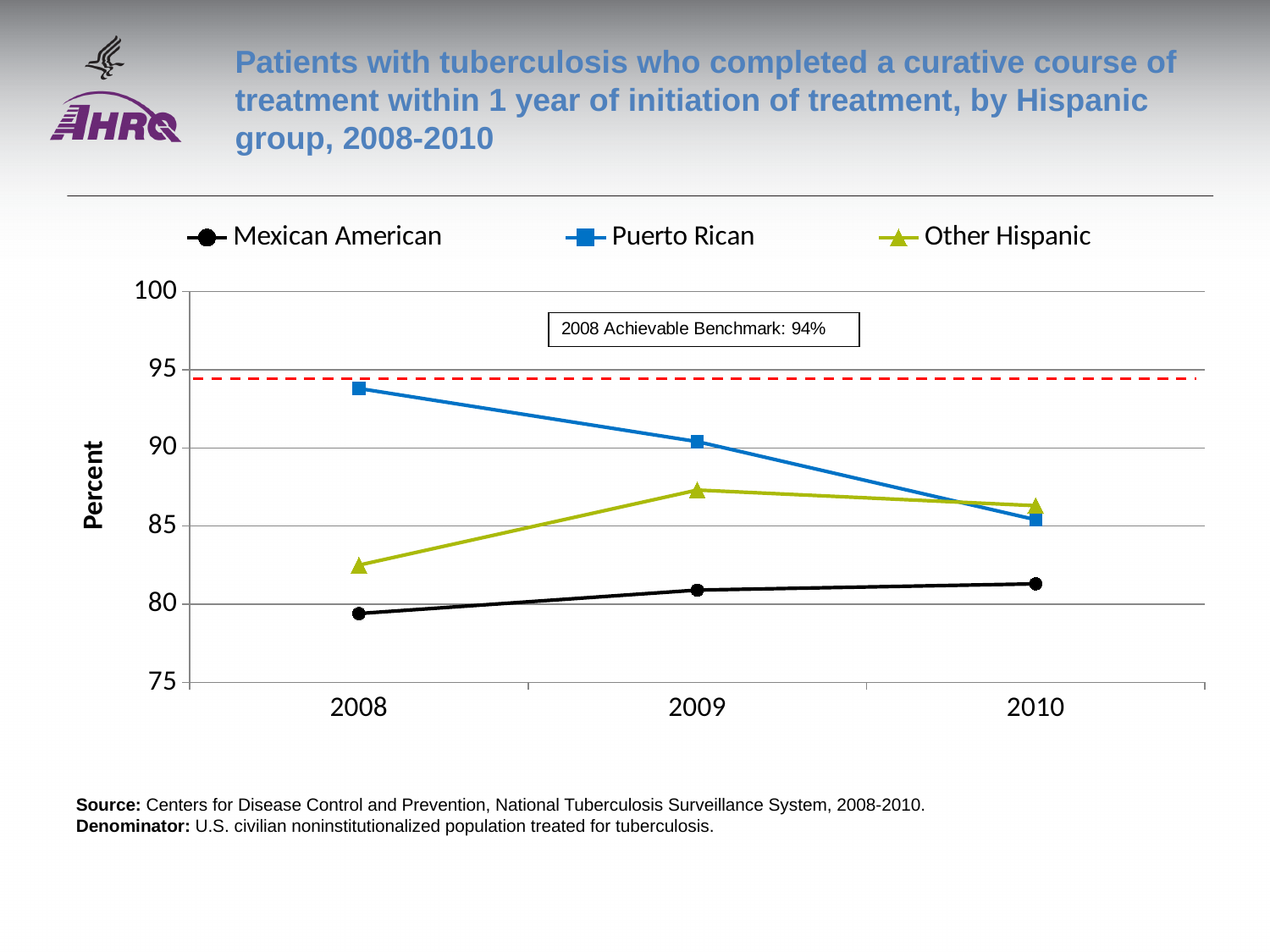
Is the value for Mexican American in 2008 greater or less than 80? less What kind of chart is shown on the slide? line chart Which group had the highest value in 2008? Puerto Rican How many years are plotted along the x axis? 3 In 2009, which is larger: the value for Other Hispanic or the value for Mexican American? Other Hispanic Is the value for Other Hispanic in 2008 greater or less than 85? less How many series does the legend list? 3 What is the 2008 Achievable Benchmark shown on the chart? 94% Is the value for Other Hispanic in 2009 greater or less than 85? greater Does the value for Puerto Rican rise or fall from 2008 to 2010? fall Which group had the lowest value in 2010? Mexican American